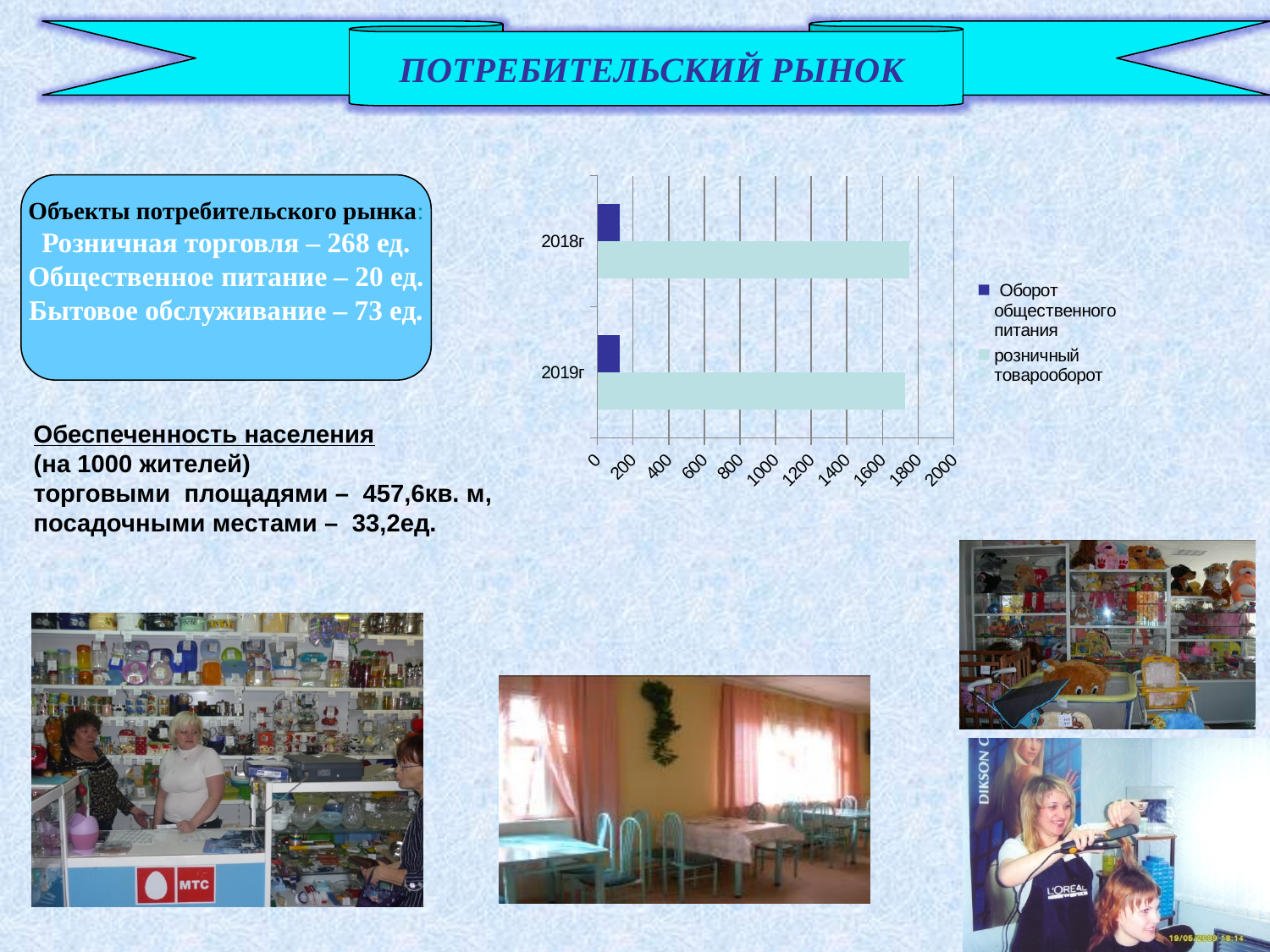
How many years (categories) are shown on the chart? 2 How many series does the chart legend list? 2 Is the value of Оборот общественного питания for 2018г greater or less than 200? less Is the value of розничный товарооборот for 2018г greater or less than 1600? greater What is the maximum value shown on the chart's value axis? 2000 Which years are shown as categories on the chart? 2018г and 2019г Which series is drawn in dark blue on the chart? Оборот общественного питания For 2019г, which is larger: розничный товарооборот or Оборот общественного питания? розничный товарооборот Is the value of Оборот общественного питания for 2019г greater or less than 400? less For 2018г, which series has the smaller value? Оборот общественного питания What kind of chart is shown on the slide? bar chart